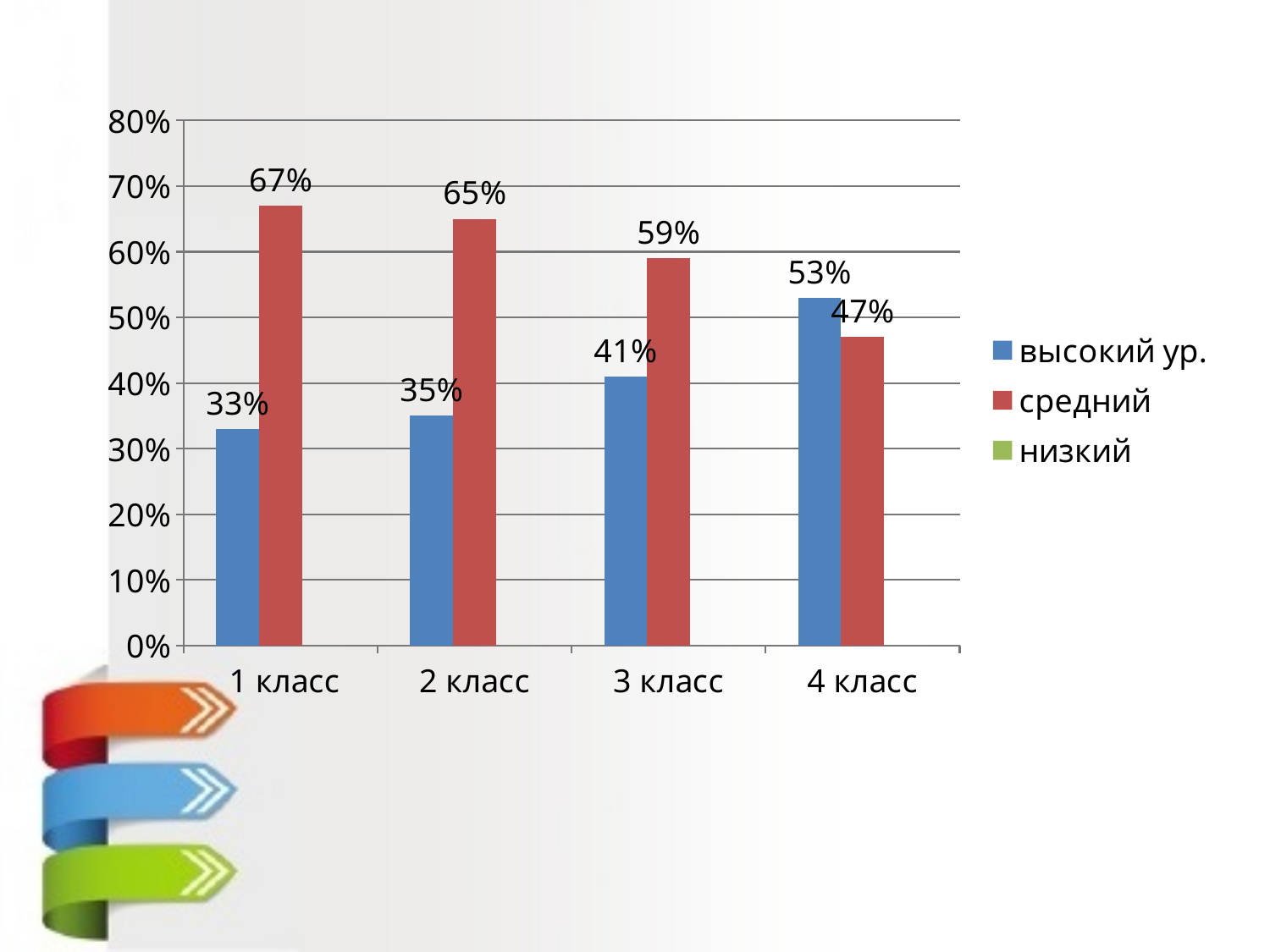
Which category has the lowest value for высокий ур.? 1 класс Do the values for высокий ур. rise or fall from 1 класс to 4 класс? rise What is the difference between средний and высокий ур. in 2 класс? 30% Which category has the highest value for средний? 1 класс What kind of chart is this? bar chart Which is larger in 4 класс, высокий ур. or средний? высокий ур. Is the value for средний in 3 класс greater or less than 50%? greater What is the value for средний in 3 класс? 59% How many series does the legend list? 3 What is the value for высокий ур. in 4 класс? 53% What is the value for высокий ур. in 1 класс? 33% How many categories are shown on the x axis? 4